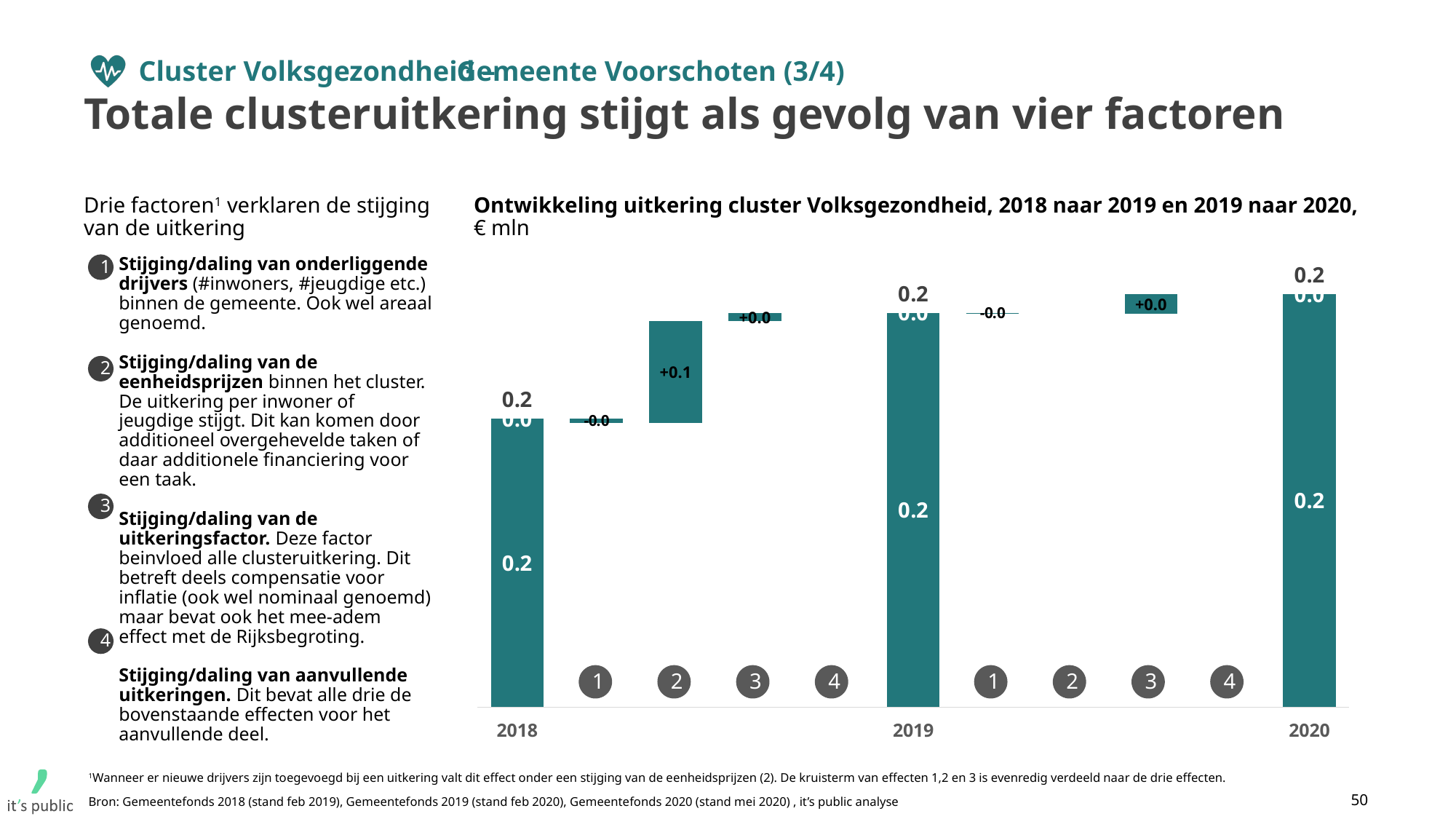
What is the value of factor 2 (eenheidsprijzen) in the step from 2018 to 2019? +0.1 How many year totals (2018, 2019, 2020) are shown as full bars in the chart? 3 What is the title of the chart? Ontwikkeling uitkering cluster Volksgezondheid, 2018 naar 2019 en 2019 naar 2020, € mln Which factor has the largest effect in the step from 2018 to 2019? Factor 2 In what unit are the values in the chart expressed? € mln Does the total uitkering rise, fall or stay the same from 2018 to 2020 according to the labels? Stays the same (0.2) What is the total uitkering shown for 2020? 0.2 What is the total uitkering shown for 2018? 0.2 What kind of chart is shown on the slide? Bar chart (waterfall) What is the value of factor 3 in the step from 2019 to 2020? +0.0 What is the total uitkering shown for 2019? 0.2 What is the value of factor 1 in the step from 2018 to 2019? -0.0